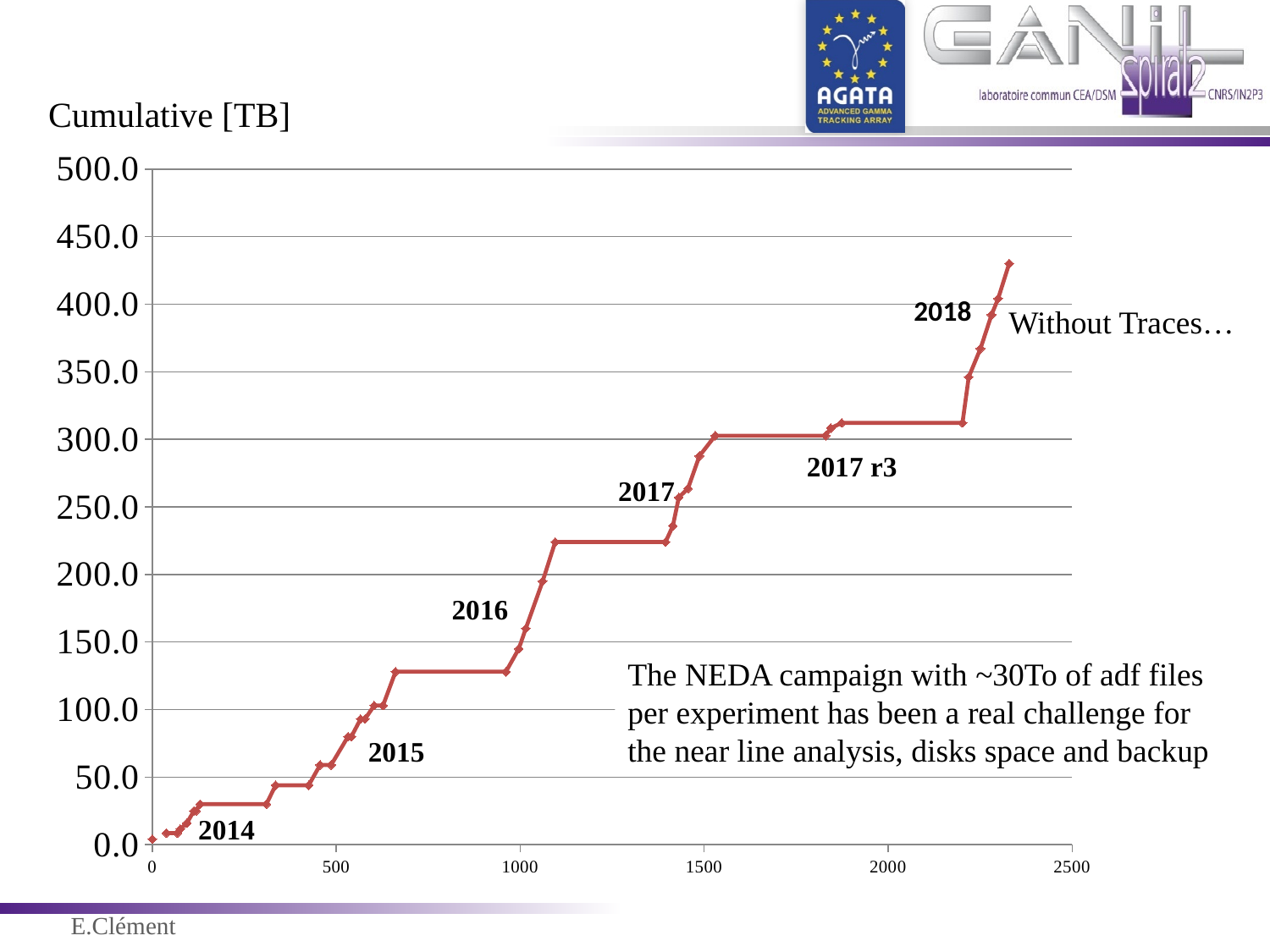
Is the value of the flat section near the 2017 r3 label (between about x = 1900 and x = 2200) greater or less than 350? less Is the value of the flat section labelled 2016 (between about x = 1100 and x = 1400) greater or less than 200? greater Do the plotted values rise or fall as you move along the x axis? rise Is the highest plotted value, at the end of the line near x = 2300, greater or less than 400? greater What is the highest tick value shown on the y axis? 500.0 What kind of chart is shown on the slide? line chart What label is written above the y axis of the chart? Cumulative [TB]